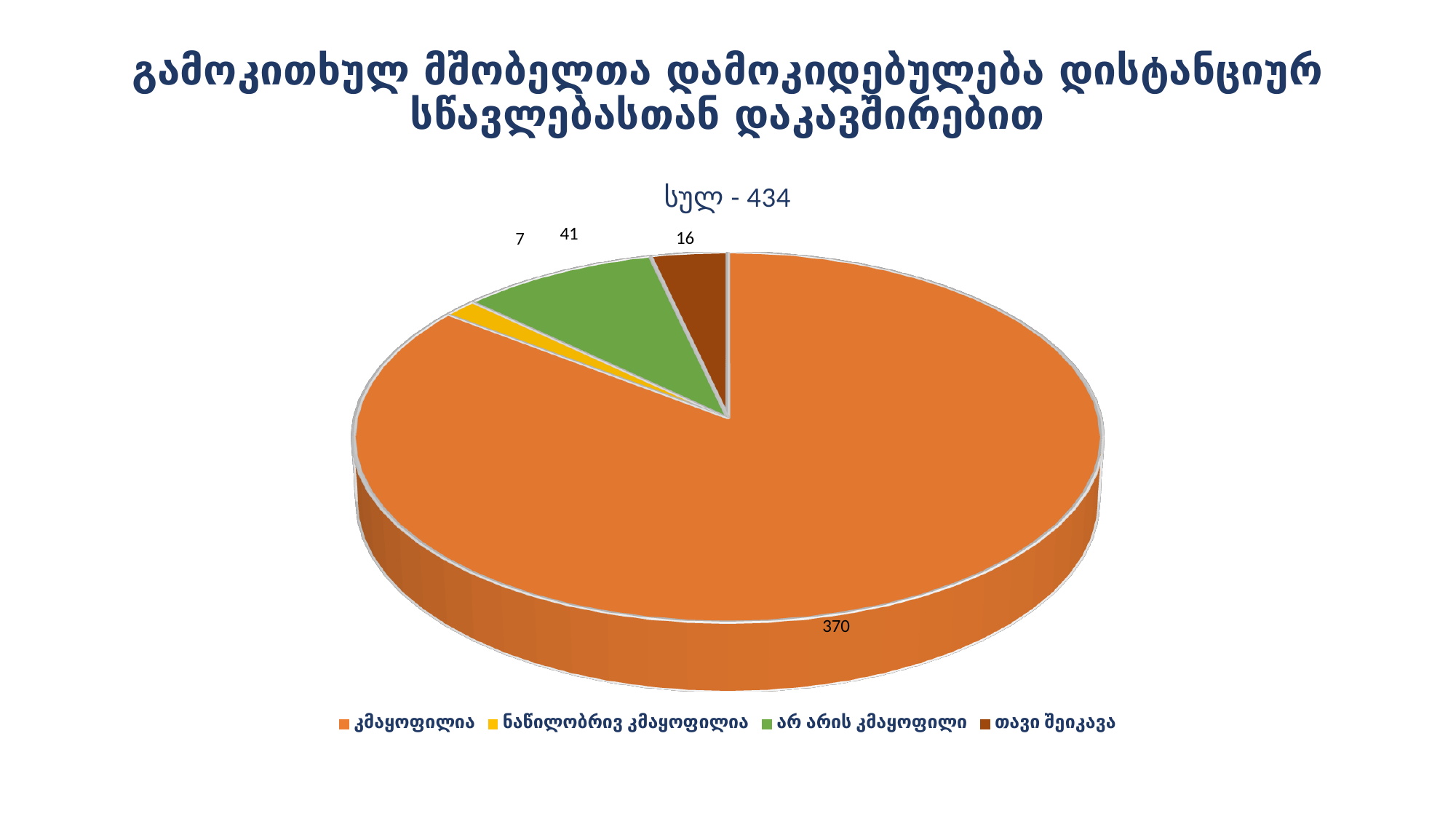
What is the difference between the values for არ არის კმაყოფილი and თავი შეიკავა? 25 Which category has the smallest slice of the pie? ნაწილობრივ კმაყოფილია What is the value for არ არის კმაყოფილი? 41 What is the value for ნაწილობრივ კმაყოფილია? 7 What type of chart is shown on the slide? Pie chart What is the value for კმაყოფილია? 370 Which is larger, the value for თავი შეიკავა or the value for ნაწილობრივ კმაყოფილია? თავი შეიკავა Which category has the largest slice of the pie? კმაყოფილია What total is stated in the chart title? 434 How many categories does the legend list? 4 What is the difference between the values for კმაყოფილია and არ არის კმაყოფილი? 329 What is the value for თავი შეიკავა? 16